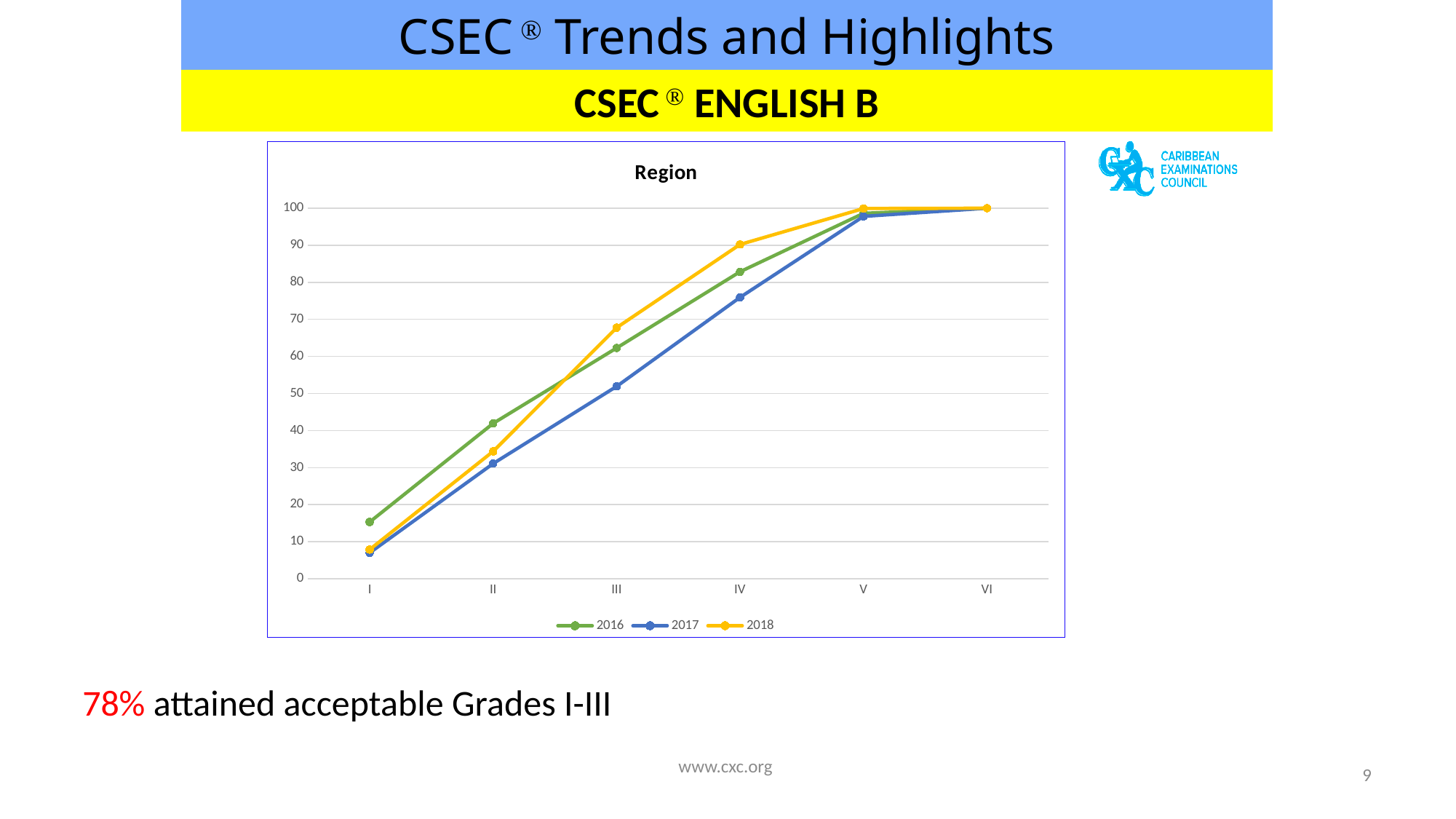
What kind of chart is shown on the slide? line chart Which years are listed in the legend? 2016, 2017, 2018 Is the value for 2018 at category III greater or less than 60? greater What is the title of the chart? Region Is the value for 2016 at category I greater or less than 10? greater Do the values for 2017 rise or fall from category I to category VI? rise How many categories are shown on the x axis? 6 What is the value for 2018 at category VI? 100 Which series has the highest value at category I? 2016 At category III, which is larger: the value for 2018 or the value for 2017? 2018 Is the value for 2017 at category I greater or less than 10? less How many series does the legend list? 3